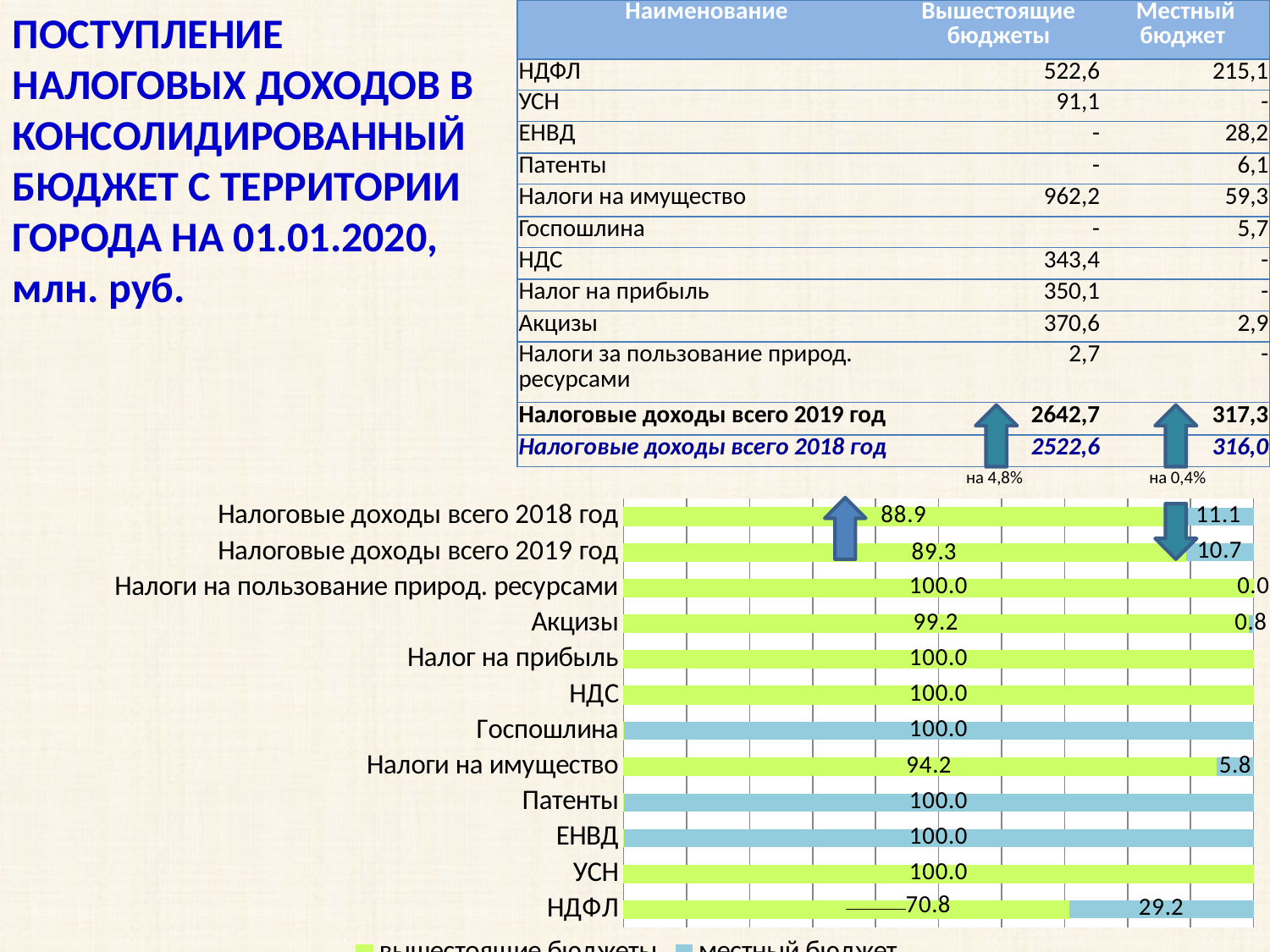
How many series does the legend of the bar chart list? 2 What kind of chart is shown at the bottom of the slide? bar chart In the bar chart, what is the value of the green segment for Акцизы? 99.2 In the bar chart, which category has the largest blue (местный бюджет) segment? ЕНВД, Патенты and Госпошлина (100.0 each) In the bar chart, what is the value of the blue segment for Налоговые доходы всего 2018 год? 11.1 In the bar chart, what is the value of the green segment for Налоговые доходы всего 2019 год? 89.3 In the bar chart, what is the difference between the green segment values for Налоговые доходы всего 2019 год and Налоговые доходы всего 2018 год? 0.4 In the bar chart, which is larger: the blue segment for Налоговые доходы всего 2018 год or for Налоговые доходы всего 2019 год? Налоговые доходы всего 2018 год In the bar chart, what is the value of the blue (местный бюджет) segment for НДФЛ? 29.2 In the bar chart, what is the value of the green (вышестоящие бюджеты) segment for НДФЛ? 70.8 In the bar chart, how many categories are plotted? 12 In the bar chart, what is the value of the blue (местный бюджет) segment for Налоги на имущество? 5.8